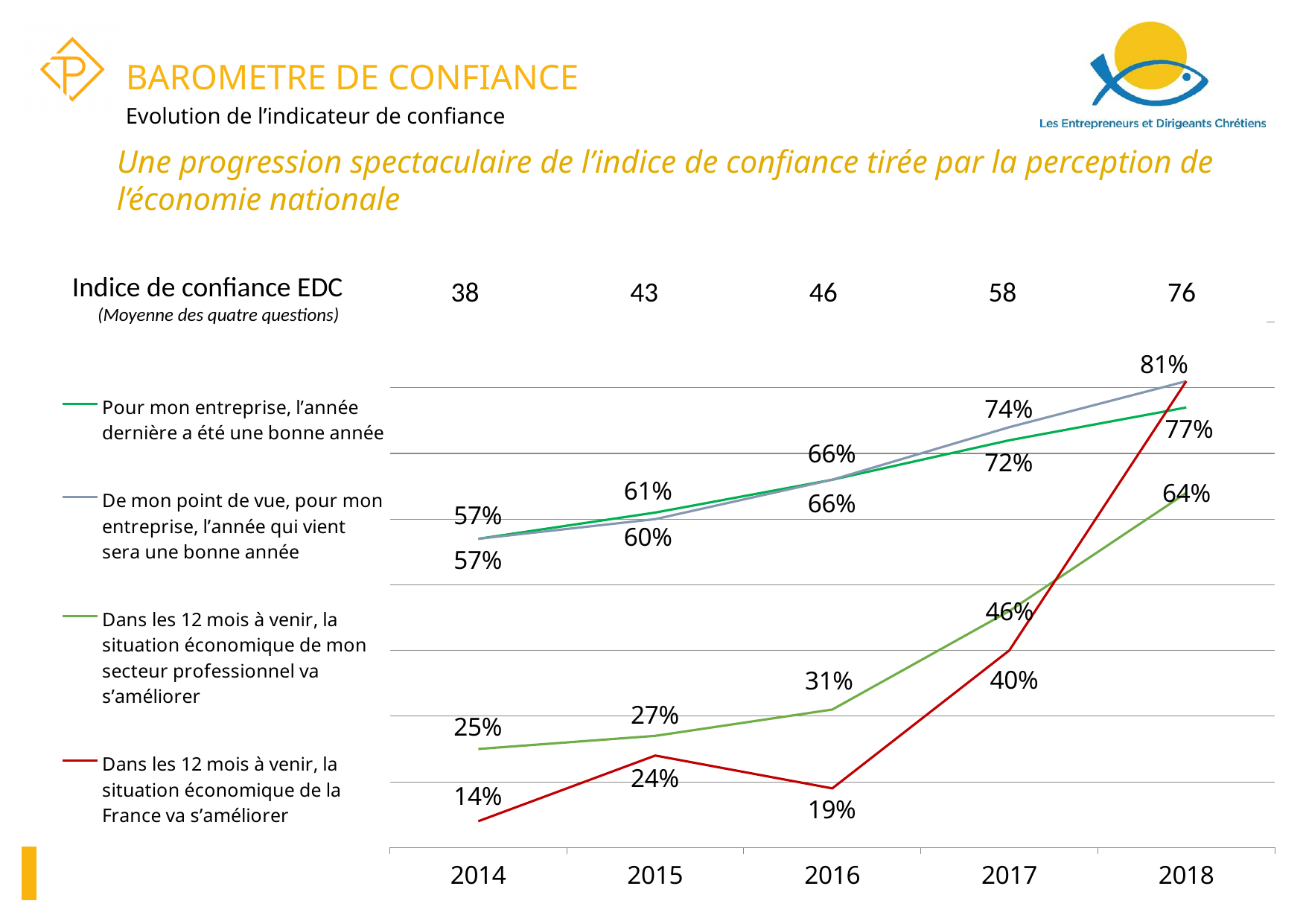
What is the 2017 value for 'De mon point de vue, pour mon entreprise, l'année qui vient sera une bonne année'? 74% What is the 2016 value for 'Dans les 12 mois à venir, la situation économique de la France va s'améliorer'? 19% What is the 2017 value for 'Dans les 12 mois à venir, la situation économique de mon secteur professionnel va s'améliorer'? 46% How many years are plotted along the x axis? 5 By how many percentage points did 'Dans les 12 mois à venir, la situation économique de mon secteur professionnel va s'améliorer' increase from 2014 to 2018? 39 percentage points What is the 2014 value for 'Dans les 12 mois à venir, la situation économique de la France va s'améliorer'? 14% In which year is the value for 'Dans les 12 mois à venir, la situation économique de la France va s'améliorer' lowest? 2014 In 2016, which is larger: the value for the France economic situation series or the professional sector series? the professional sector series (31%) In which year is the value for 'Dans les 12 mois à venir, la situation économique de mon secteur professionnel va s'améliorer' highest? 2018 What kind of chart is shown on the slide? line chart What is the 2015 value for 'Pour mon entreprise, l'année dernière a été une bonne année'? 61% How many series does the legend list? 4